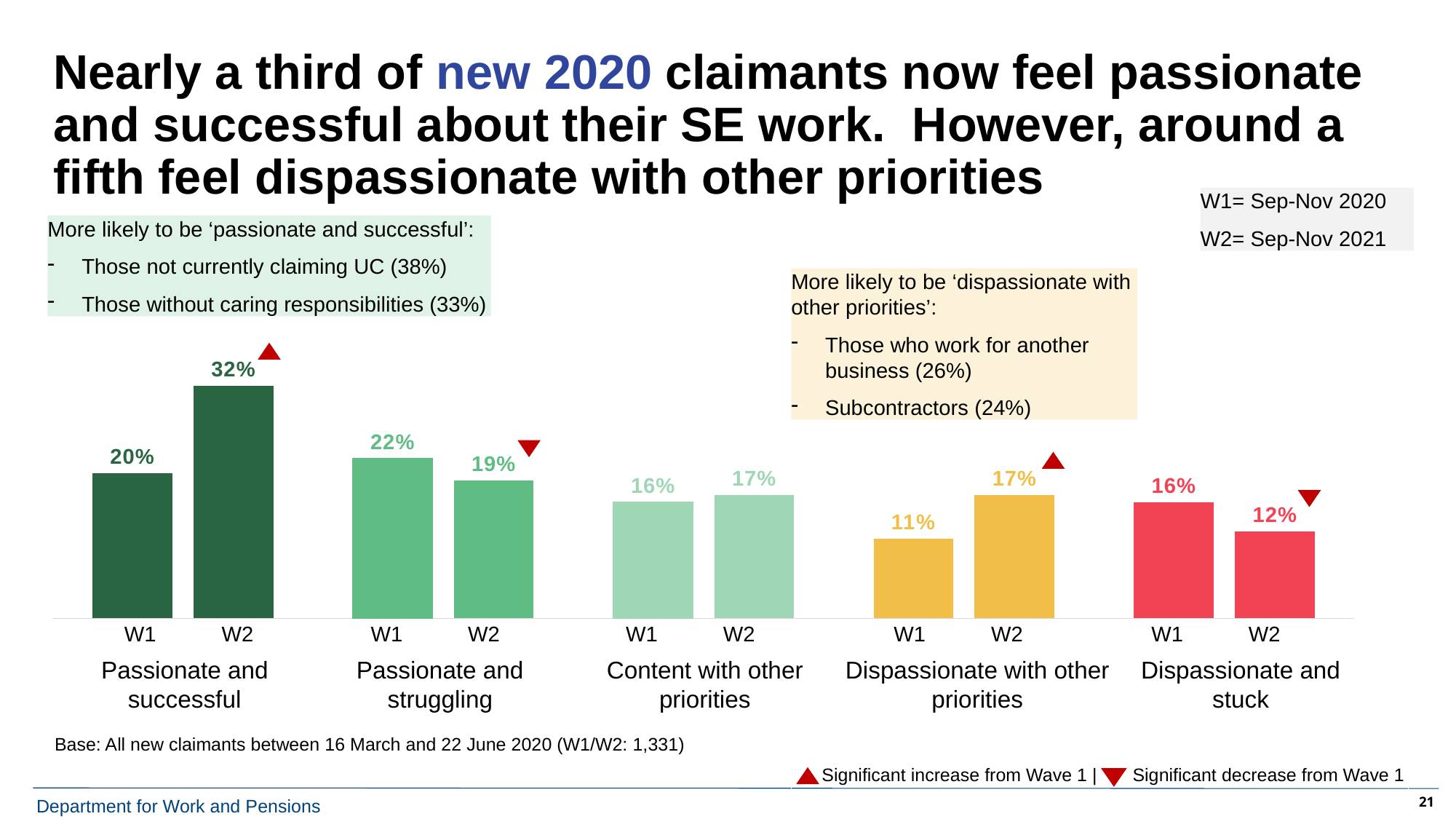
Which category has the highest W2 value? Passionate and successful According to the key on the slide, what does a red upward triangle above a bar indicate? Significant increase from Wave 1 Which is larger: the W1 value for 'Passionate and struggling' or the W1 value for 'Content with other priorities'? Passionate and struggling What is the W1 value for 'Dispassionate with other priorities'? 11% Which category has the lowest W1 value? Dispassionate with other priorities What is the difference between the W1 and W2 values for 'Dispassionate and stuck'? 4 percentage points What is the W2 value for 'Passionate and successful'? 32% What is the W1 value for 'Passionate and struggling'? 22% What is the W2 value for 'Dispassionate and stuck'? 12% What is the difference between the W2 and W1 values for 'Passionate and successful'? 12 percentage points What kind of chart is shown on the slide? Bar chart How many categories are shown on the x axis of the chart? 5